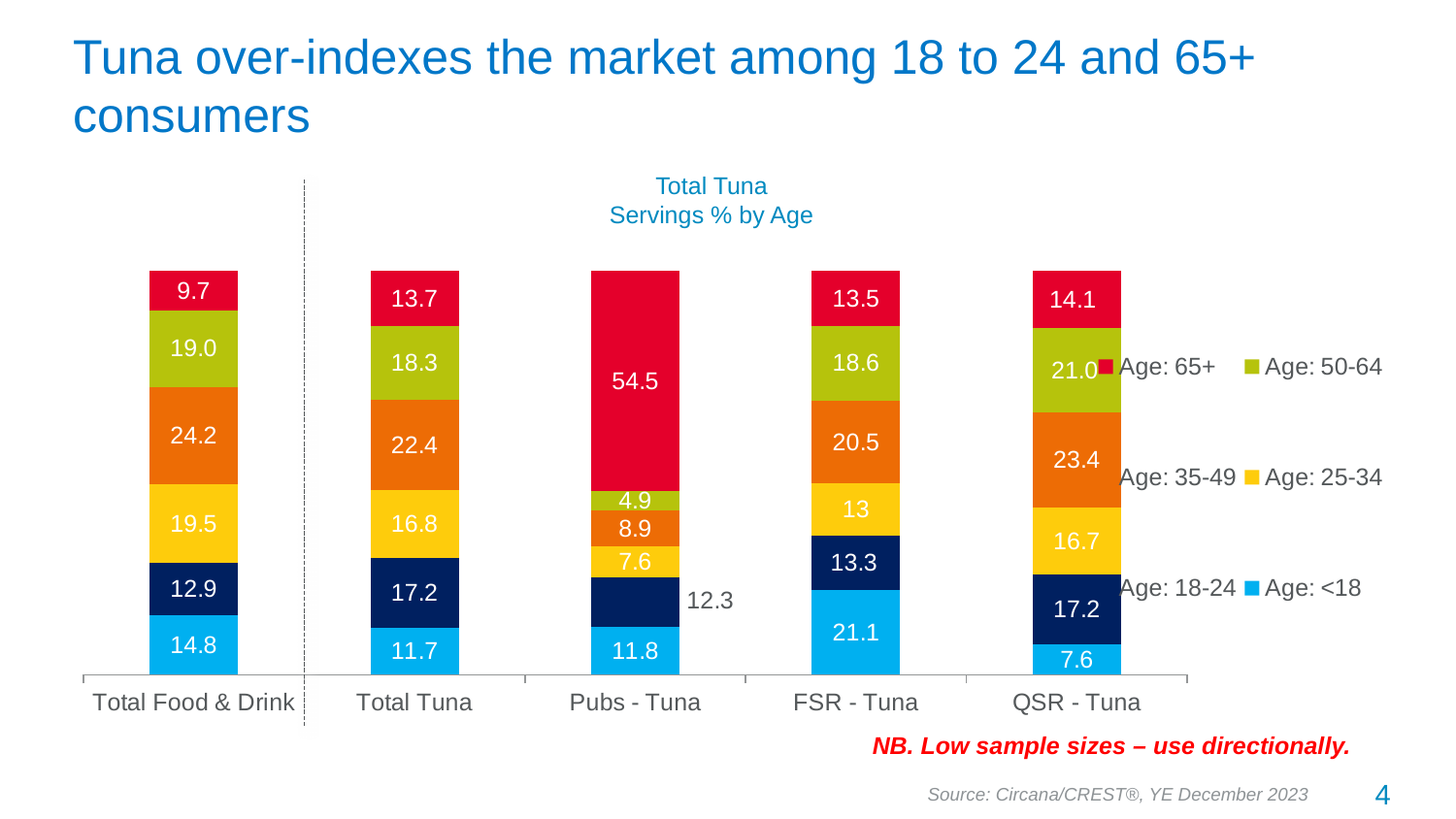
What kind of chart is shown on the slide? Stacked bar chart How many categories are shown on the x axis? 5 How many series does the legend list? 6 What is the Age: <18 value for FSR - Tuna? 21.1 Which category has the highest Age: 65+ value? Pubs - Tuna What is the Age: 65+ value for Pubs - Tuna? 54.5 Which has the larger Age: 18-24 value, Total Tuna or Total Food & Drink? Total Tuna What is the Age: 50-64 value for QSR - Tuna? 21.0 What is the difference between the Age: 65+ values for Pubs - Tuna and Total Tuna? 40.8 What is the Age: 35-49 value for Total Food & Drink? 24.2 What is the difference between the Age: 35-49 values for Total Food & Drink and Total Tuna? 1.8 Which category has the lowest Age: <18 value? QSR - Tuna